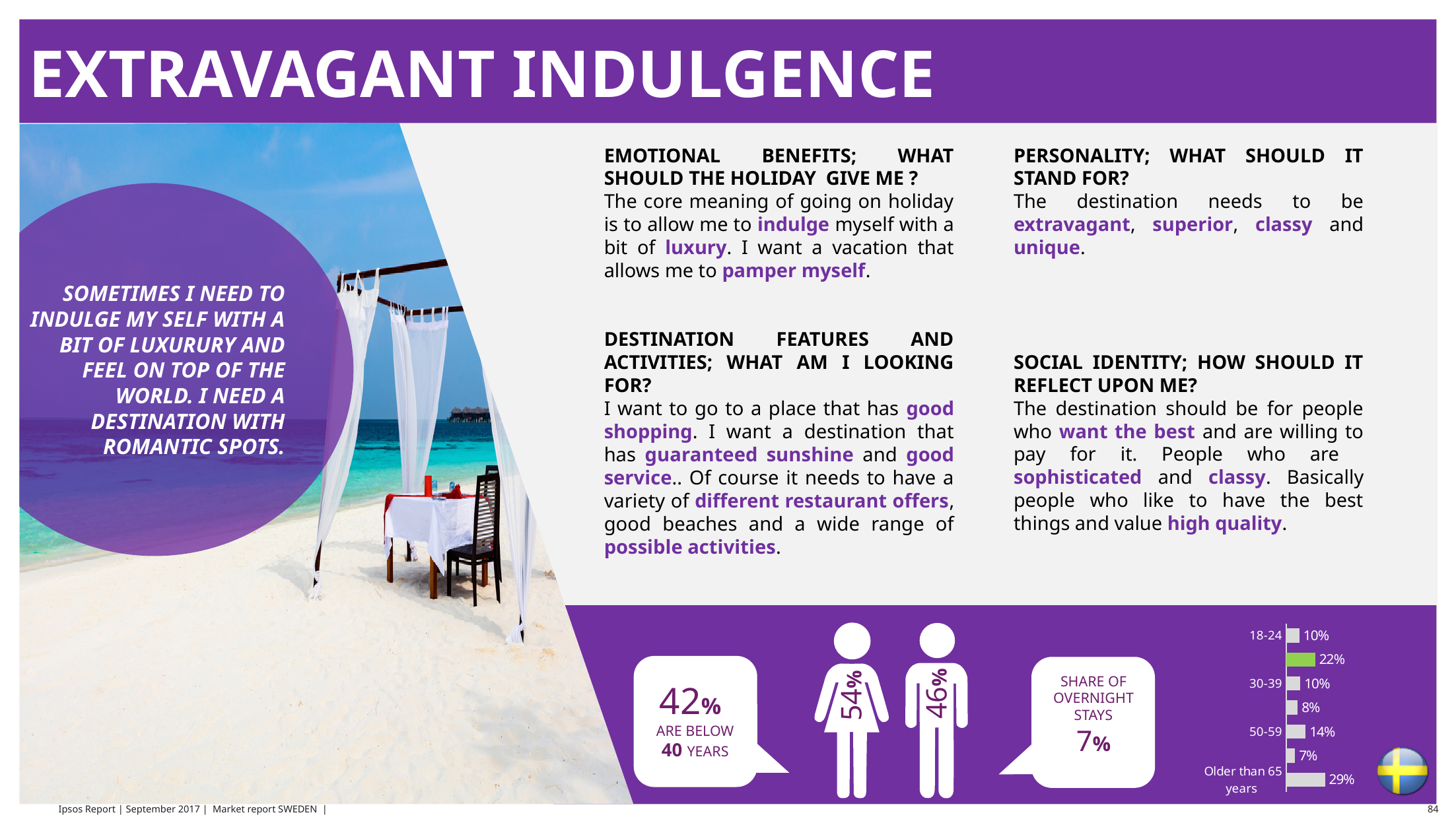
What type of chart is used to show the age distribution at the bottom right of the slide? bar chart In the age distribution bar chart, which labelled age group has the highest value? Older than 65 years In the age distribution bar chart, what is the difference between the 'Older than 65 years' group and the 50-59 group? 15% In the age distribution bar chart, what is the highest value shown on any bar? 29% In the age distribution bar chart, what is the value for the 50-59 age group? 14% How many bars are shown in the age distribution bar chart? 7 In the age distribution bar chart, what is the value for the 'Older than 65 years' group? 29% In the age distribution bar chart, what is the value for the 18-24 age group? 10% In the age distribution bar chart, which is larger: the value for 50-59 or the value for 30-39? 50-59 In the age distribution bar chart, what colour is the bar with the value 22%? green In the age distribution bar chart, what is the value for the 30-39 age group? 10% In the age distribution bar chart, what is the difference between the 50-59 group and the 18-24 group? 4%